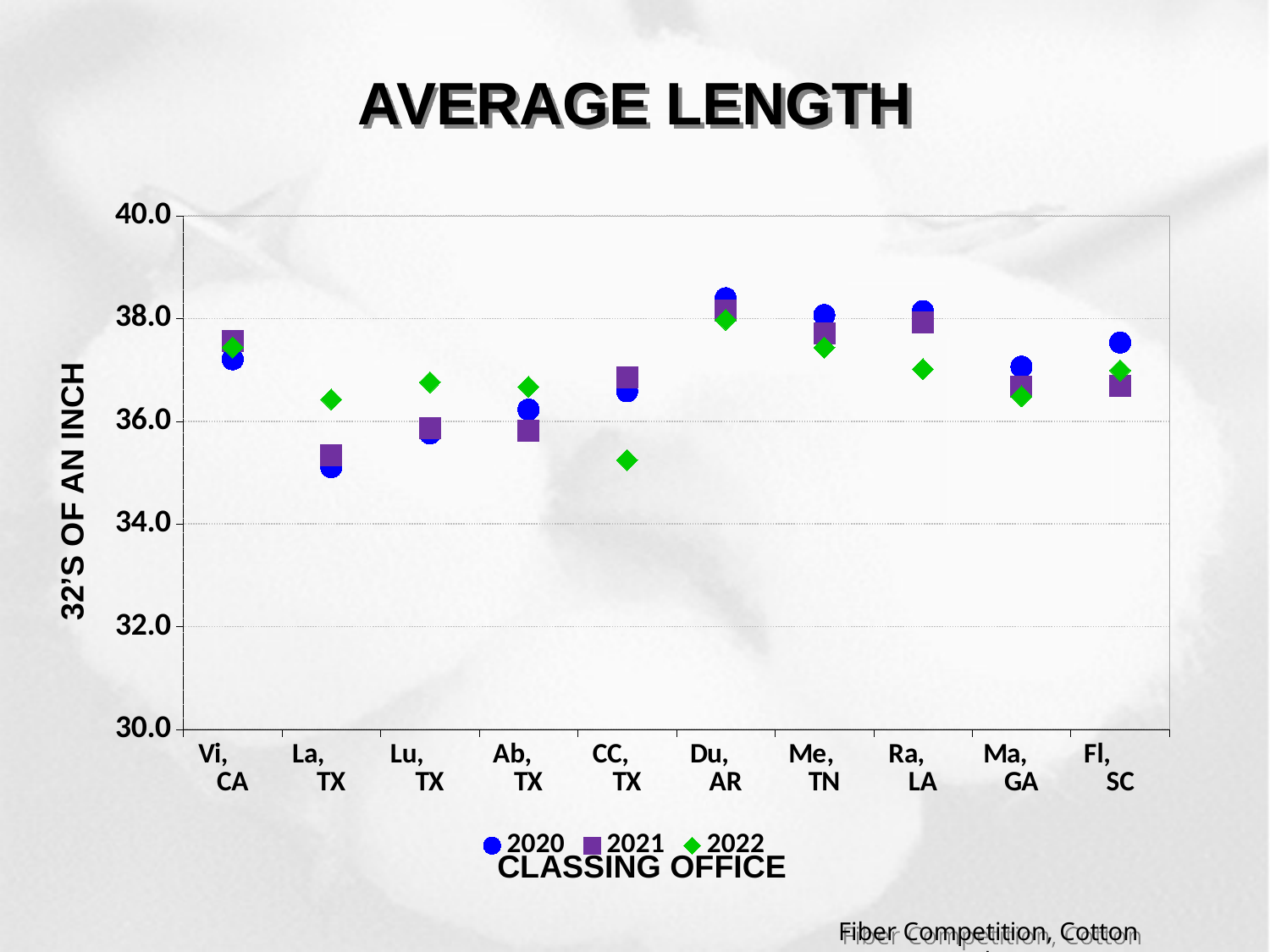
At CC, TX, which series has the larger value, 2021 or 2022? 2021 At La, TX, which series has the larger value, 2020 or 2022? 2022 How many series does the legend list? 3 Which classing office has the lowest 2020 average length? La, TX Which classing office has the lowest 2022 average length? CC, TX How many classing offices are shown along the x axis? 10 Is the 2020 value for La, TX greater or less than 36.0? less Which classing office has the highest 2020 average length? Du, AR What kind of chart is shown on the slide? Scatter chart What is the title of the y axis? 32'S OF AN INCH Is the 2020 value for Du, AR greater or less than 38.0? greater Is the 2022 value for Ra, LA greater or less than 38.0? less